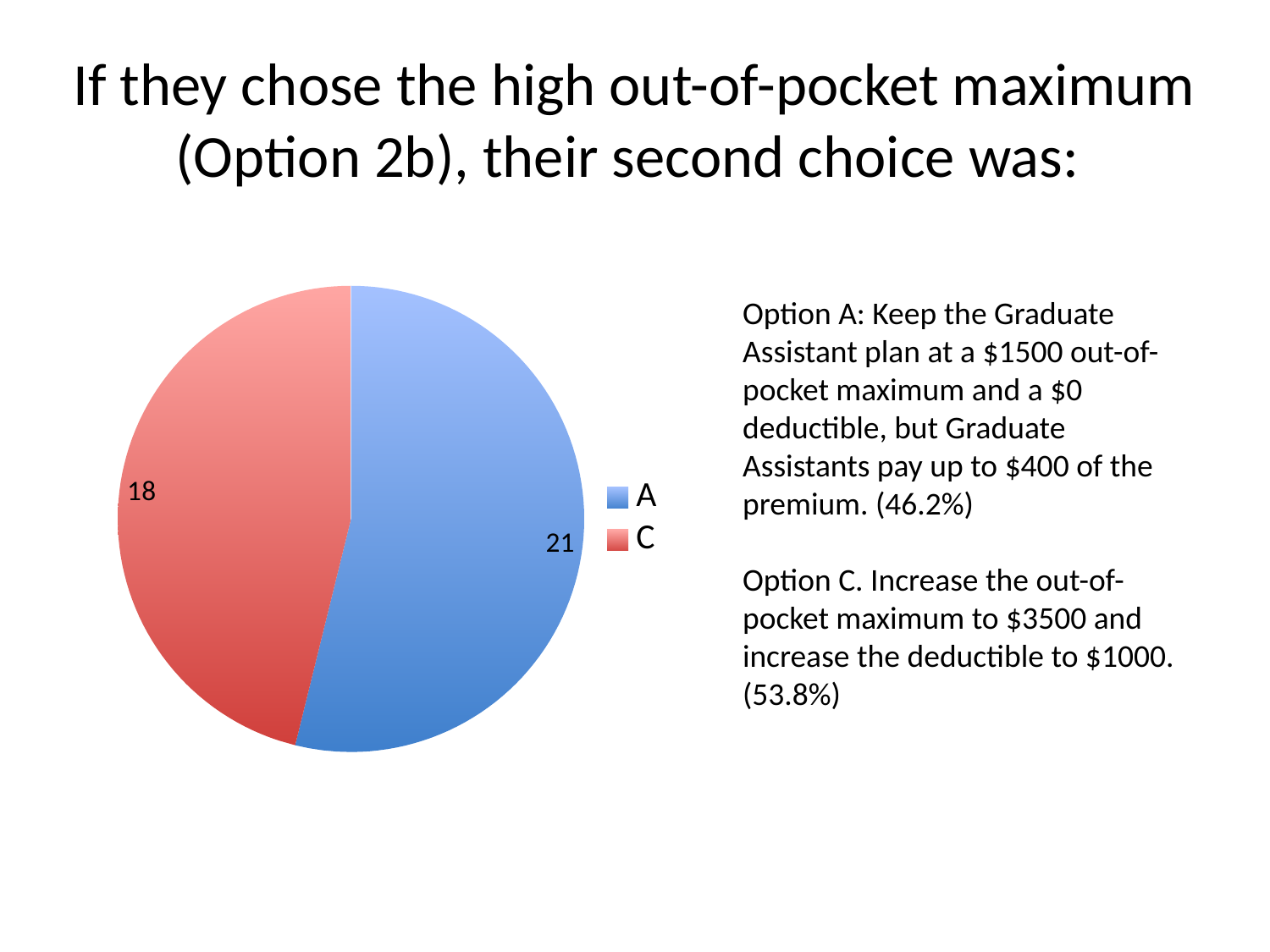
What is the value for A in the pie chart? 21 What is the total of the values shown in the pie chart? 39 What colour is the slice for A in the pie chart? blue What is the value for C in the pie chart? 18 Which is larger in the pie chart, A or C? A How many entries does the legend of the pie chart list? 2 How many slices does the pie chart have? 2 Which category has the smallest slice in the pie chart? C What is the difference between the values for A and C in the pie chart? 3 What kind of chart is shown on the slide? pie chart What colour is the slice for C in the pie chart? red Which category has the largest slice in the pie chart? A